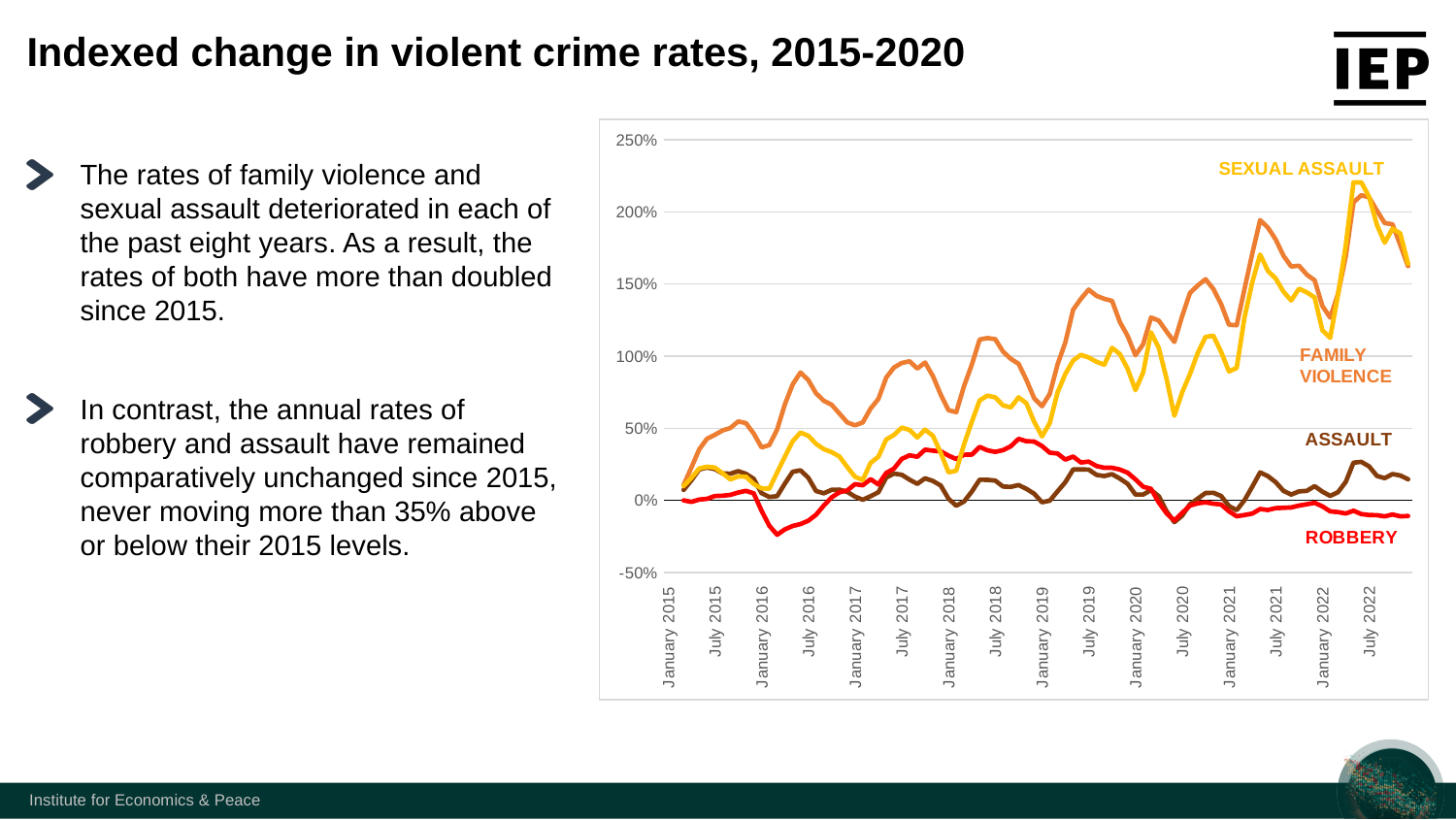
How many crime-type series are plotted on the chart? 4 What kind of chart is shown on the slide? Line chart In July 2019, which is larger: the value for Sexual Assault or the value for Robbery? Sexual Assault Is the value for Family Violence in January 2021 greater or less than 50%? greater Which series has the lowest value at the end of the chart (July 2022)? Robbery What is the title of the slide's chart? Indexed change in violent crime rates, 2015-2020 Is the value for Assault in July 2022 greater or less than 50%? less What colour is the Robbery line on the chart? Red Is the value for Robbery in January 2016 greater or less than 0%? less How many date labels are shown on the x axis? 16 Does the Sexual Assault line generally rise or fall from January 2015 to July 2022? Rise